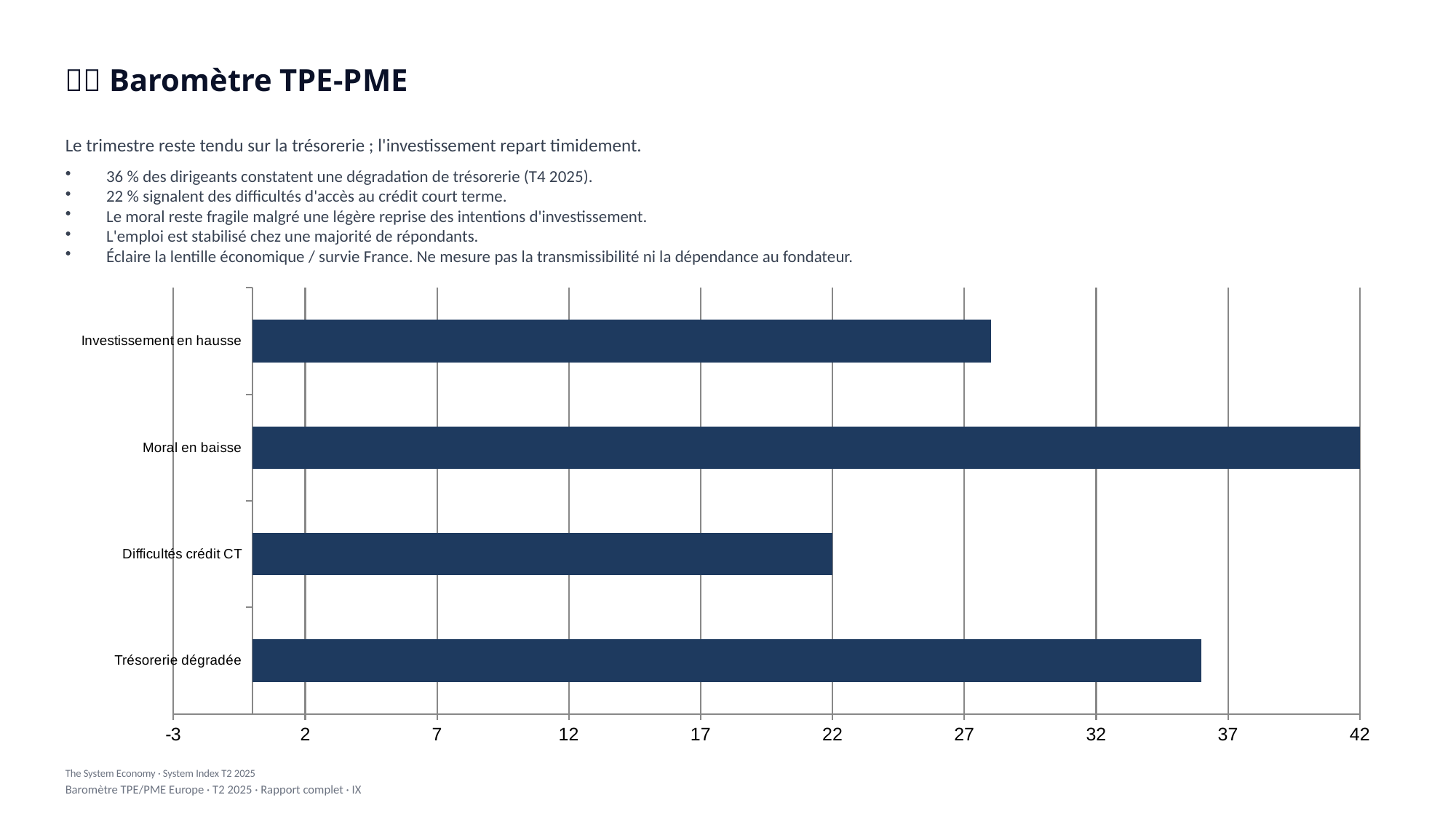
Which category has the lowest value in the chart? Difficultés crédit CT What kind of chart is shown on the slide? bar chart Which category has the highest value in the chart? Moral en baisse Which is larger, the value for Trésorerie dégradée or the value for Investissement en hausse? Trésorerie dégradée What is the value for Moral en baisse? 42 What is the difference between the values for Moral en baisse and Difficultés crédit CT? 20 Is the value for Investissement en hausse greater or less than 32? less How many categories are plotted in the chart? 4 Is the value for Trésorerie dégradée greater or less than 37? less Which category is listed at the bottom of the chart? Trésorerie dégradée What is the value for Difficultés crédit CT? 22 Is the value for Trésorerie dégradée greater or less than 32? greater